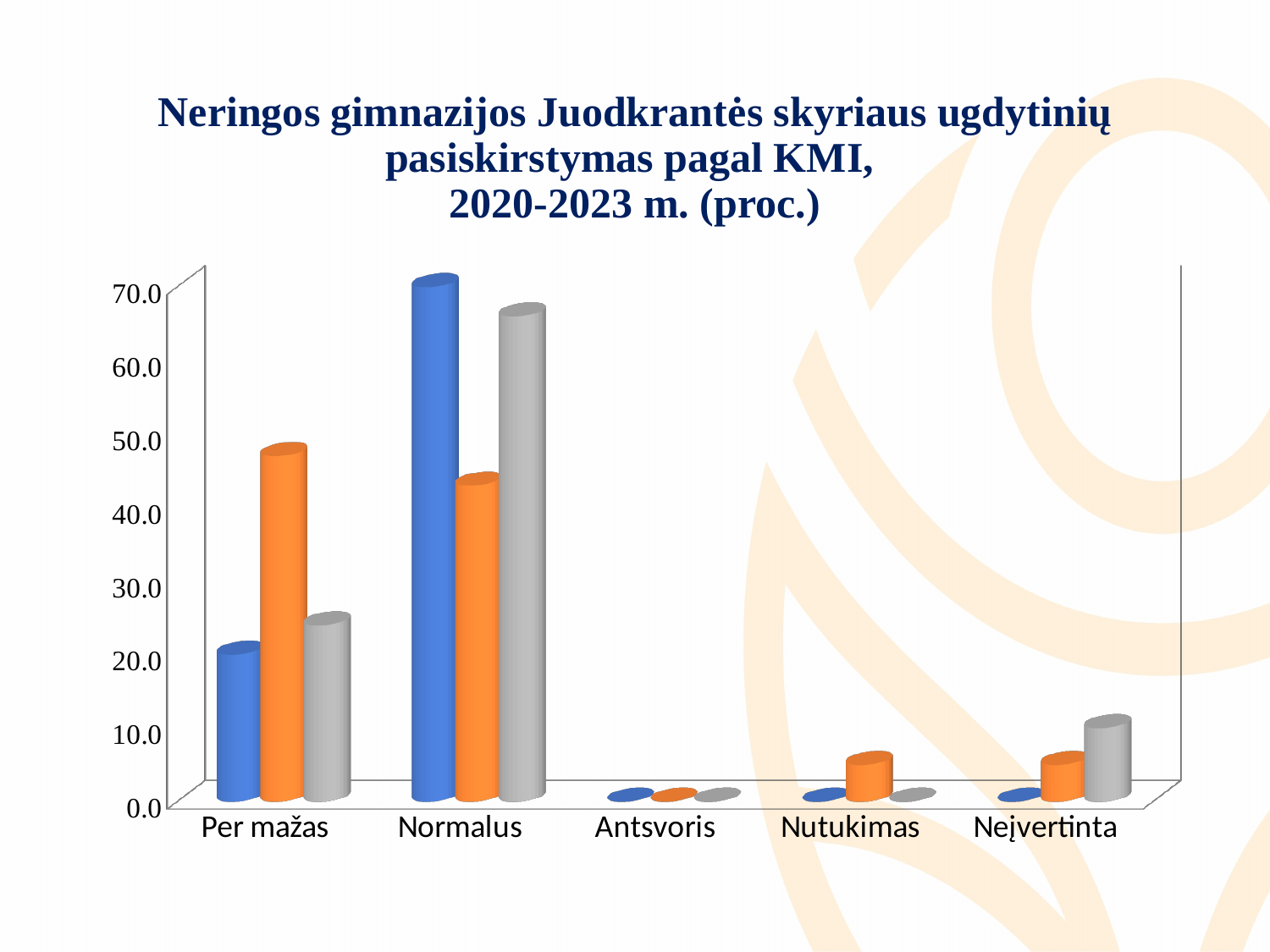
What kind of chart is shown on the slide? bar chart For Per mažas, which is larger: the blue bar or the orange bar? the orange bar Which category has all of its bars at essentially zero? Antsvoris Which category has the tallest bar in the chart? Normalus How many categories are shown on the x axis of the chart? 5 For Normalus, which is larger: the blue bar or the orange bar? the blue bar Is the gray bar for Normalus greater or less than 60? greater Is the orange bar for Normalus greater or less than 50? less What period does the chart title say the data covers? 2020-2023 m. Is the orange bar for Nutukimas greater or less than 10? less How many bars (series) are plotted for each category in the chart? 3